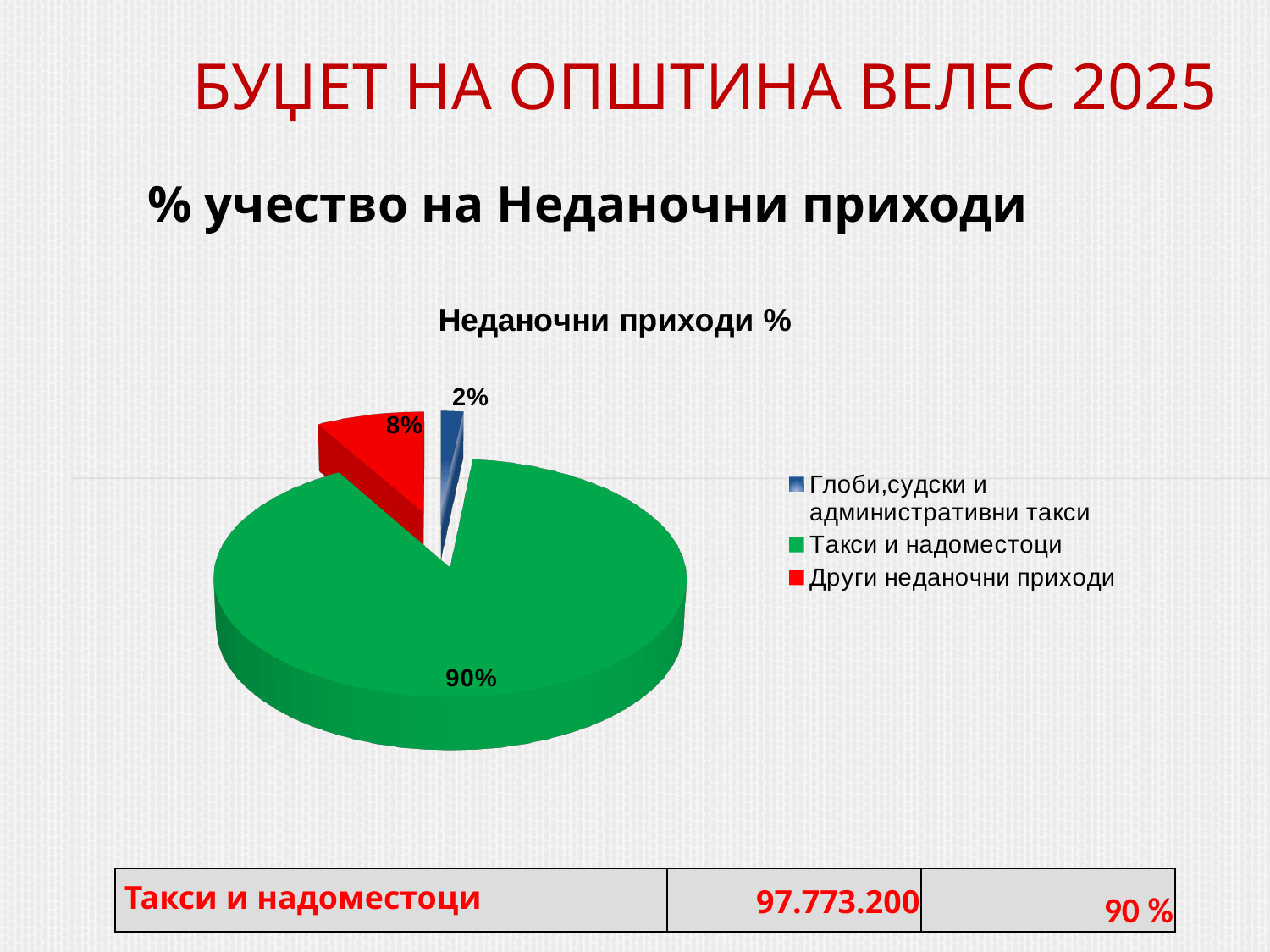
Which is larger, the slice for Други неданочни приходи or the slice for Глоби,судски и административни такси? Други неданочни приходи What colour is the slice for Такси и надоместоци? Green What share of the pie does Глоби,судски и административни такси have? 2% What is the difference in percentage points between Такси и надоместоци and Други неданочни приходи? 82 What is the combined share of Други неданочни приходи and Глоби,судски и административни такси? 10% What type of chart is shown on the slide? Pie chart Which category has the smallest slice of the pie? Глоби,судски и административни такси What share of the pie does Такси и надоместоци have? 90% Which category has the largest slice of the pie? Такси и надоместоци How many categories does the legend list? 3 What is the title of the chart? Неданочни приходи % What share of the pie does Други неданочни приходи have? 8%